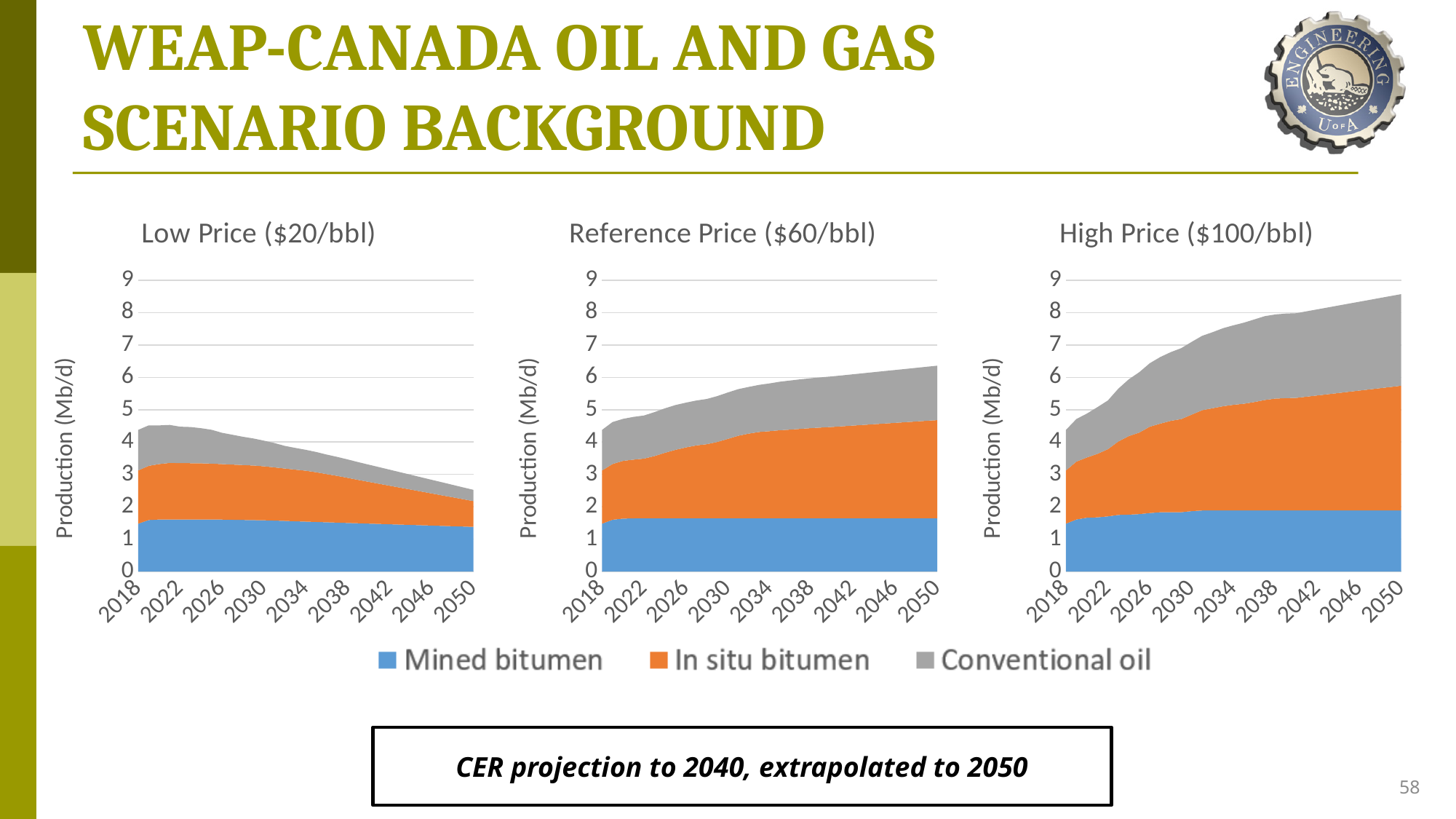
In the Low Price ($20/bbl) chart, is total production in 2050 greater or less than 3? less In the High Price ($100/bbl) chart, does total production rise or fall from 2018 to 2050? rise What oil price is given in the title of the Reference Price chart? $60/bbl What kind of chart is the Low Price ($20/bbl) chart? stacked area chart How many charts are shown on the slide? 3 How many series does the shared legend list for the charts? 3 In the High Price ($100/bbl) chart, is total production in 2050 greater or less than 8? greater In the Low Price ($20/bbl) chart, is Mined bitumen production in 2018 greater or less than 2? less In the Low Price ($20/bbl) chart, does total production rise or fall from 2018 to 2050? fall Which chart shows higher total production in 2050, the High Price ($100/bbl) chart or the Low Price ($20/bbl) chart? High Price ($100/bbl) What is the y-axis label on the Reference Price chart? Production (Mb/d)